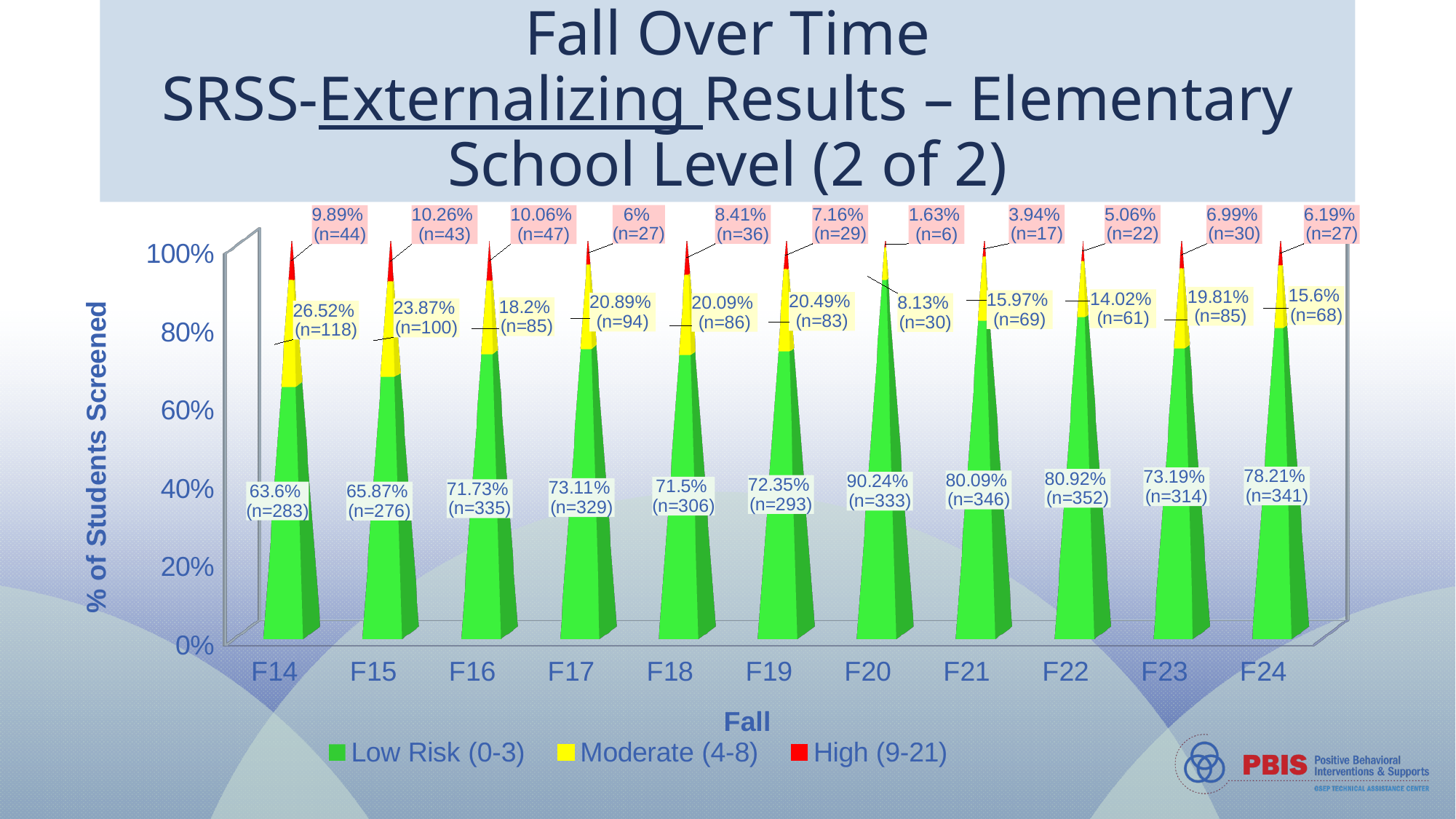
Which fall has the highest Low Risk (0-3) percentage? F20 Which fall has the highest Moderate (4-8) percentage? F14 What is the difference in percentage points between the Low Risk (0-3) value for F24 and for F14? 14.61 percentage points What is the label of the y axis? % of Students Screened How many series does the legend list? 3 Which is larger, the High (9-21) percentage for F16 or for F17? F16 Which fall has the lowest High (9-21) percentage? F20 How many fall time points are shown on the x axis? 11 What is the Low Risk (0-3) percentage for F20? 90.24% What is the High (9-21) percentage for F15? 10.26% What is the Moderate (4-8) percentage for F23? 19.81% How many students were in the Low Risk (0-3) group in F22? n=352